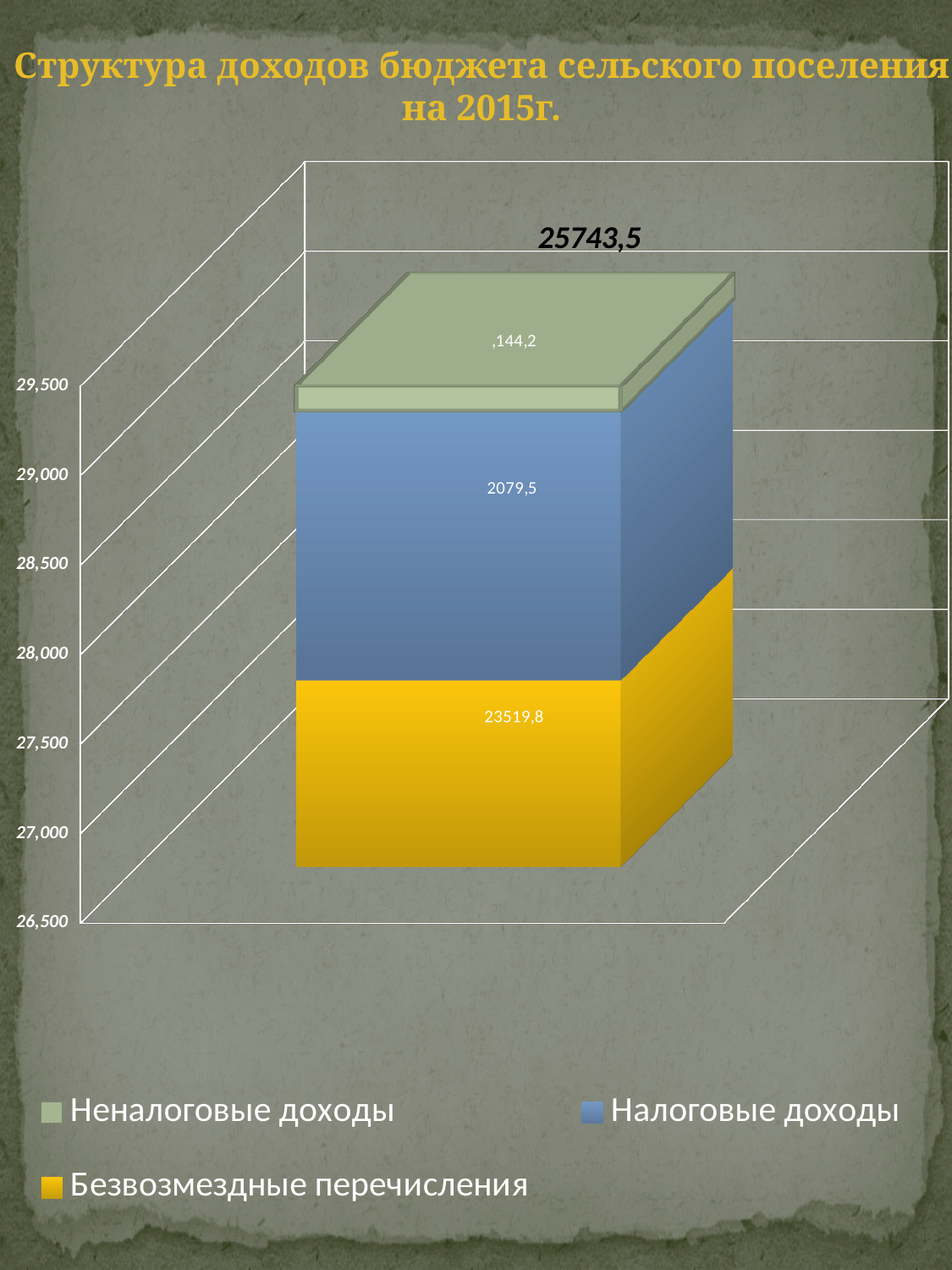
Which series has the smallest value in the bar? Неналоговые доходы What is the value of the Налоговые доходы segment? 2079,5 What is the difference between Налоговые доходы and Неналоговые доходы? 1935,3 Which is larger, Налоговые доходы or Неналоговые доходы? Налоговые доходы How many series does the legend list? 3 What kind of chart is shown on the slide? Stacked bar chart What is the total of the stacked bar, as printed above it? 25743,5 What is the difference between Безвозмездные перечисления and Налоговые доходы? 21440,3 What is the value of the Безвозмездные перечисления segment? 23519,8 Which series has the largest value in the bar? Безвозмездные перечисления Which colour represents Налоговые доходы in the legend? Blue What is the value of the Неналоговые доходы segment? 144,2